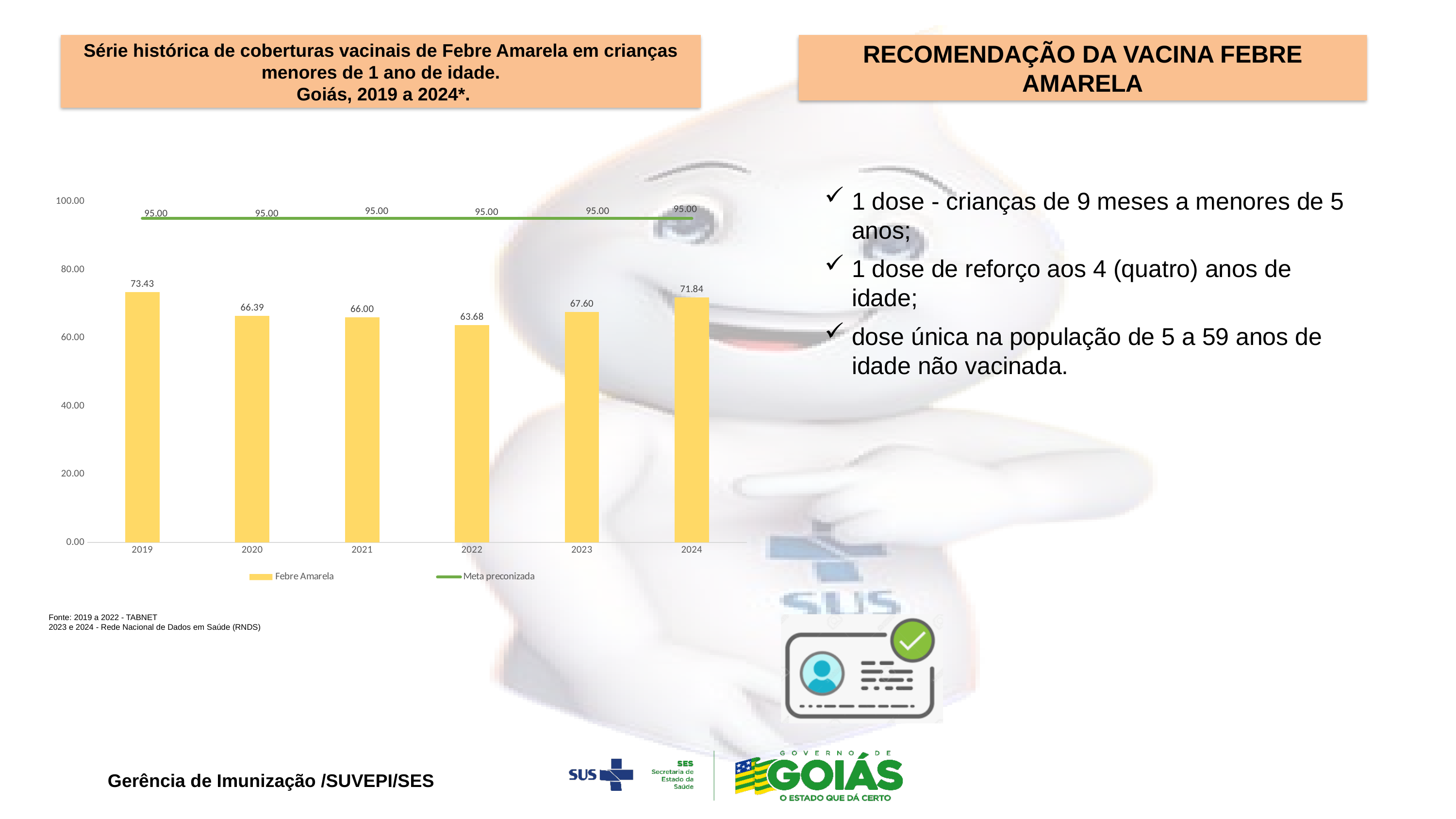
How many years are shown on the x axis of the chart? 6 What is the difference between the Febre Amarela coverage in 2019 and in 2022? 9.75 Which year has the highest Febre Amarela coverage? 2019 Which year has the lowest Febre Amarela coverage? 2022 What is the Febre Amarela coverage value for 2024? 71.84 What kind of chart is used to show the Febre Amarela coverage values? Bar chart What colour are the Febre Amarela bars in the chart? Yellow Which year has a higher Febre Amarela coverage, 2023 or 2024? 2024 What is the Febre Amarela coverage value for 2019? 73.43 How many series does the chart legend list? 2 What is the Meta preconizada value shown for 2021? 95.00 What is the Febre Amarela coverage value for 2022? 63.68